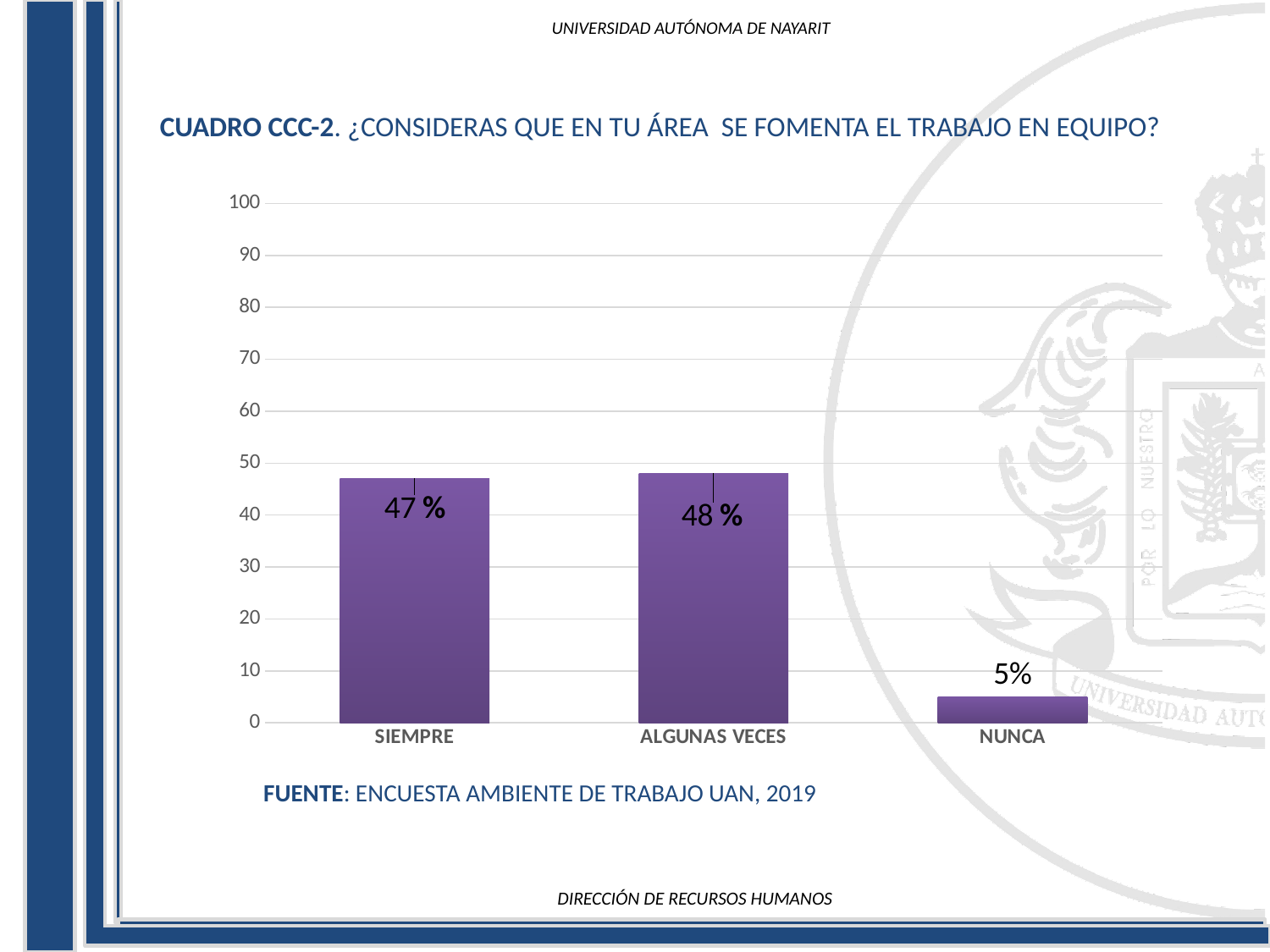
Is the value for SIEMPRE greater or less than 50? less What kind of chart is shown on the slide? bar chart What value is shown for ALGUNAS VECES? 48 % Which is larger, the value for SIEMPRE or the value for NUNCA? SIEMPRE Which category has the highest value according to the data labels? ALGUNAS VECES What value is shown for NUNCA? 5% What is the difference between the values for SIEMPRE and NUNCA? 42 How many categories are shown on the x axis? 3 Which category has the lowest value? NUNCA What is the difference between the values for ALGUNAS VECES and NUNCA? 43 Is the value for NUNCA greater or less than 10? less What value is shown for SIEMPRE? 47 %